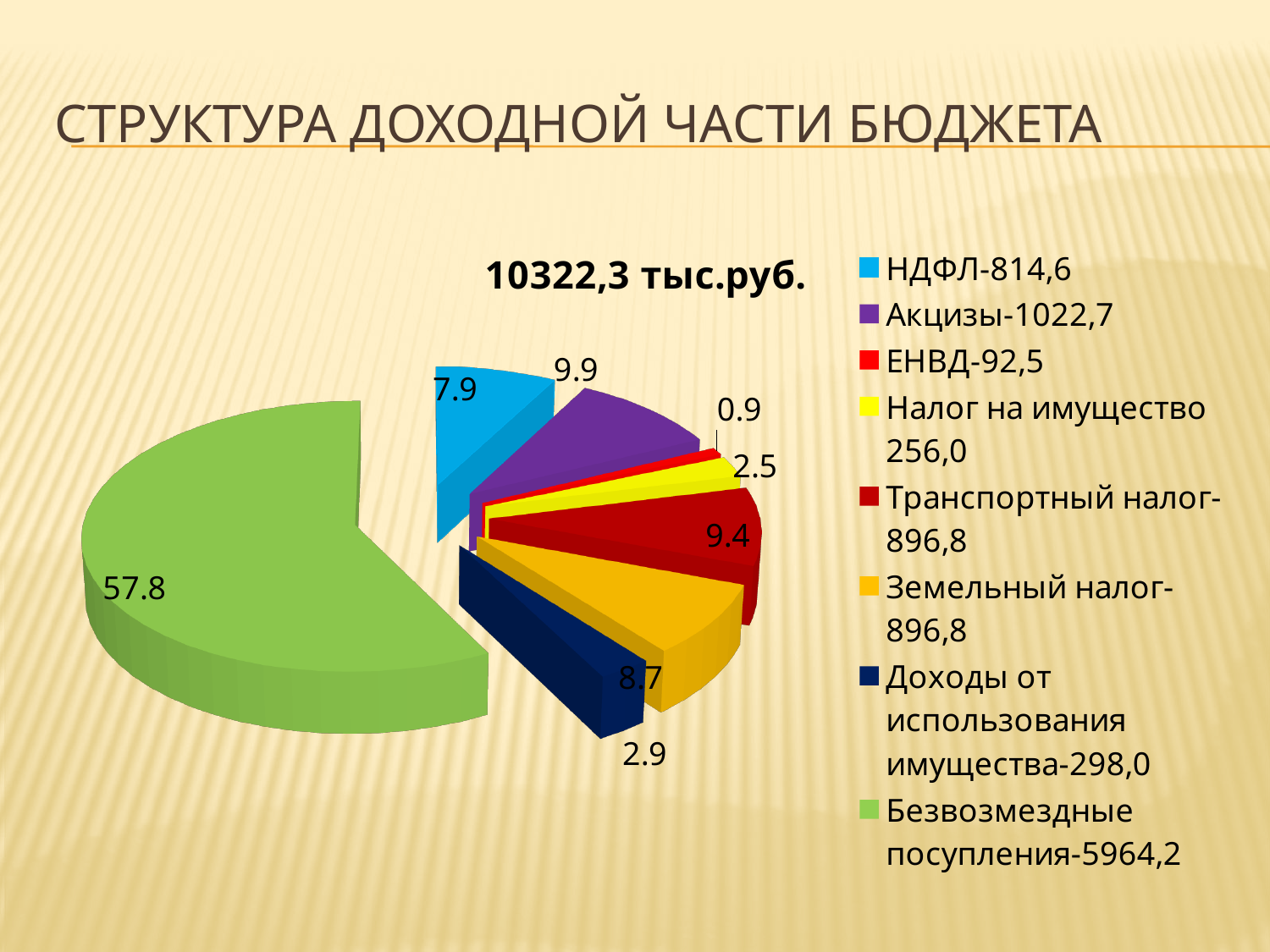
How many slices does the pie chart have? 8 What value is labelled on the slice for Безвозмездные посупления? 57.8 What is the difference between the labelled values for Безвозмездные посупления and Акцизы? 47.9 What kind of chart is shown on the slide? pie chart What value is labelled on the slice for НДФЛ? 7.9 Which category has the largest slice of the pie? Безвозмездные посупления What value is labelled on the slice for ЕНВД? 0.9 Which category has the smallest slice of the pie? ЕНВД What value is labelled on the slice for Налог на имущество? 2.5 What value is labelled on the slice for Доходы от использования имущества? 2.9 What is the title shown above the pie chart? 10322,3 тыс.руб. What value is labelled on the slice for Акцизы? 9.9